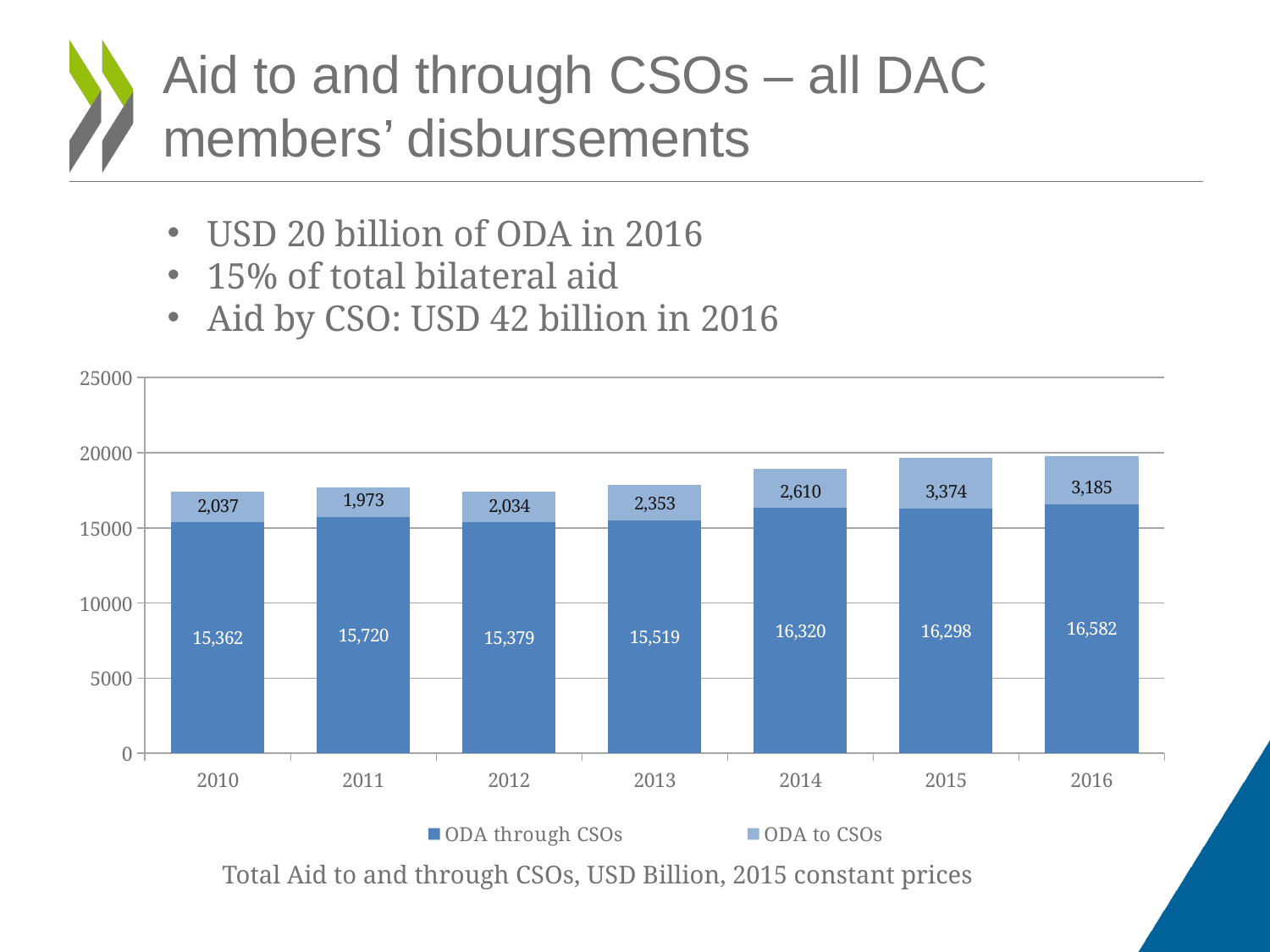
What is the value of ODA through CSOs in 2014? 16,320 What kind of chart is shown on the slide? Stacked bar chart Which year has the highest value for ODA to CSOs? 2015 Which is larger: ODA to CSOs in 2015 or in 2016? 2015 What is the value of ODA to CSOs in 2013? 2,353 How many series does the legend list? 2 Which year has the lowest value for ODA through CSOs? 2010 How many years are shown on the x axis? 7 Is the total stacked bar for 2016 greater or less than 20000? less What is the difference between ODA through CSOs in 2016 and in 2010? 1,220 Which year has the lowest value for ODA to CSOs? 2011 What is the total of the stacked bar for 2015? 19,672